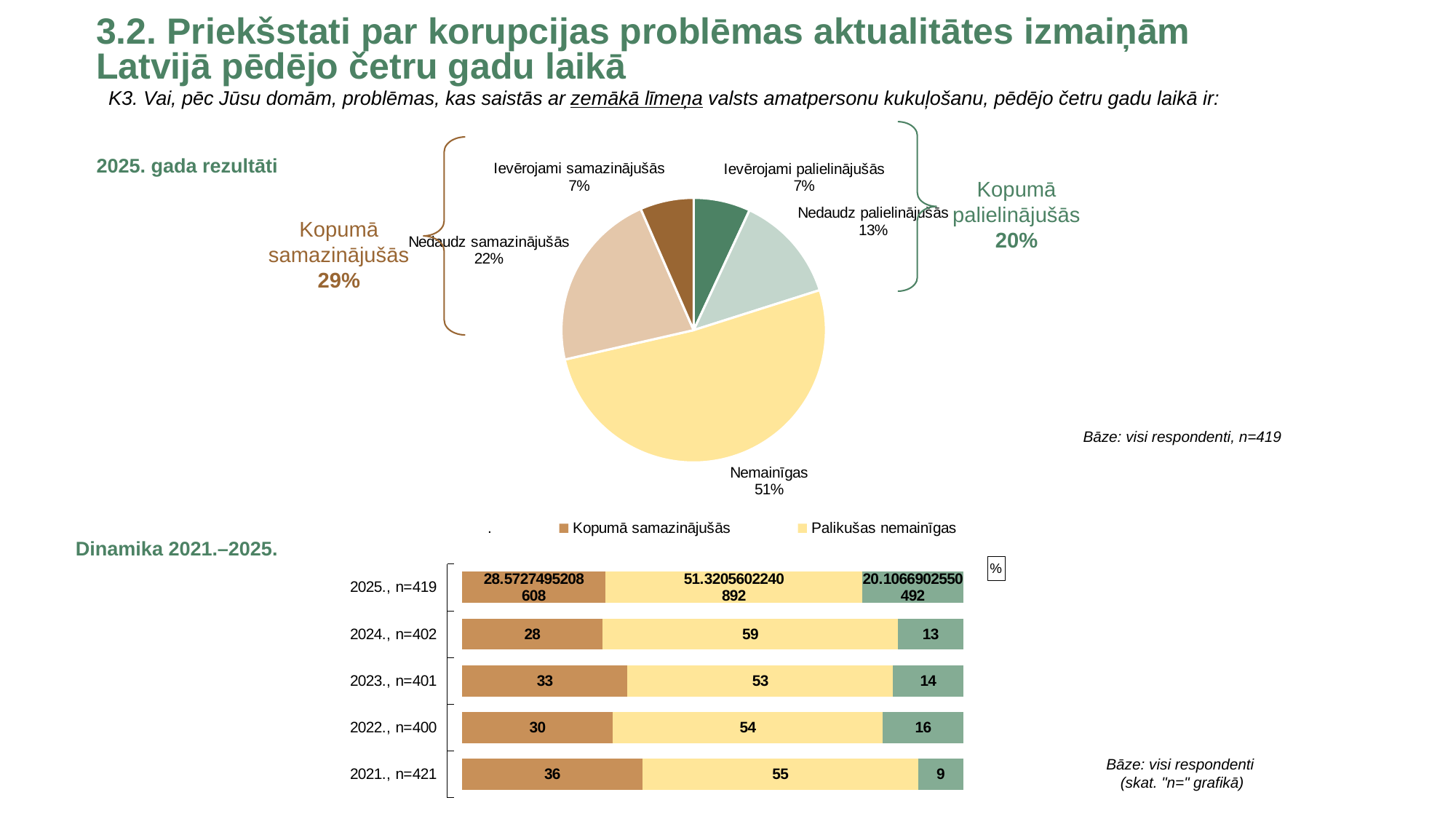
In the pie chart (2025. gada rezultāti), what share is labelled Nedaudz samazinājušās? 22% In the pie chart (2025. gada rezultāti), what share is labelled Nedaudz palielinājušās? 13% In the pie chart (2025. gada rezultāti), how many slices are there? 5 In the pie chart (2025. gada rezultāti), what share is labelled Nemainīgas? 51% In the Dinamika 2021.–2025. chart, which is larger: the Palikušas nemainīgas value for 2022., n=400 or for 2023., n=401? 2022., n=400 In the Dinamika 2021.–2025. chart, what is the value of Kopumā samazinājušās for 2021., n=421? 36 In the Dinamika 2021.–2025. chart, how many year bars are shown? 5 In the Dinamika 2021.–2025. chart, what is the value of Palikušas nemainīgas for 2024., n=402? 59 What kind of chart is the upper chart (2025. gada rezultāti)? Pie chart In the pie chart (2025. gada rezultāti), which category has the largest slice? Nemainīgas In the Dinamika 2021.–2025. chart, what is the difference between the Kopumā samazinājušās values for 2023., n=401 and 2022., n=400? 3 What kind of chart is the Dinamika 2021.–2025. chart? Stacked bar chart